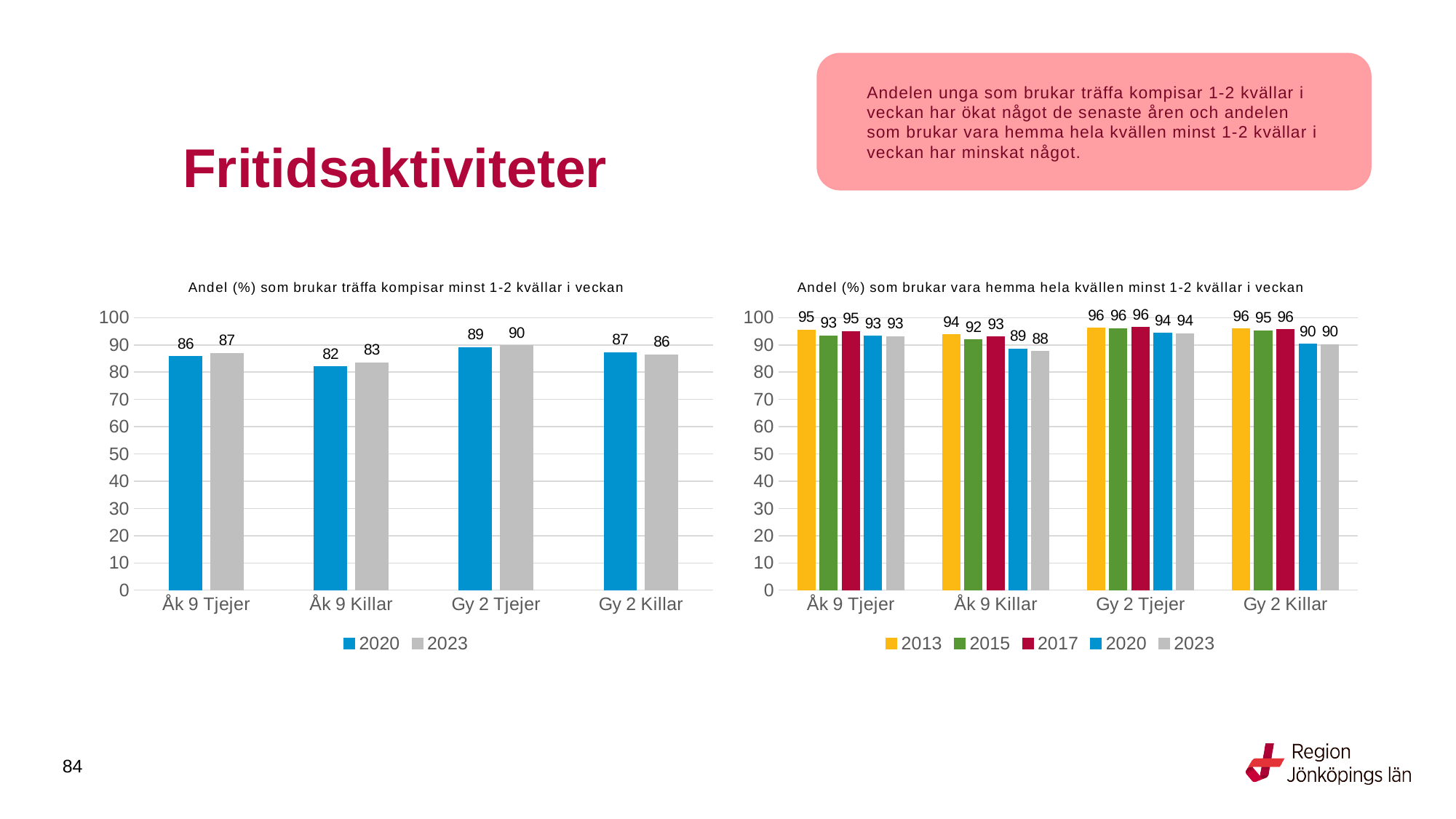
In the left chart (Andel (%) som brukar träffa kompisar minst 1-2 kvällar i veckan), what is the value for Åk 9 Killar in 2020? 82 In the right chart (Andel (%) som brukar vara hemma hela kvällen minst 1-2 kvällar i veckan), which is larger for Åk 9 Killar: the 2013 value or the 2023 value? 2013 In the right chart (Andel (%) som brukar vara hemma hela kvällen minst 1-2 kvällar i veckan), what is the value for Gy 2 Killar in 2023? 90 In the right chart (Andel (%) som brukar vara hemma hela kvällen minst 1-2 kvällar i veckan), which category has the lowest value in 2023? Åk 9 Killar In the left chart (Andel (%) som brukar träffa kompisar minst 1-2 kvällar i veckan), how many series does the legend list? 2 In the right chart (Andel (%) som brukar vara hemma hela kvällen minst 1-2 kvällar i veckan), what is the difference between the 2013 and 2023 values for Gy 2 Killar? 6 What kind of chart is the left chart (Andel (%) som brukar träffa kompisar minst 1-2 kvällar i veckan)? Bar chart In the right chart (Andel (%) som brukar vara hemma hela kvällen minst 1-2 kvällar i veckan), what is the value for Åk 9 Killar in 2020? 89 In the left chart (Andel (%) som brukar träffa kompisar minst 1-2 kvällar i veckan), which category has the lowest value in 2020? Åk 9 Killar In the right chart (Andel (%) som brukar vara hemma hela kvällen minst 1-2 kvällar i veckan), how many series does the legend list? 5 In the left chart (Andel (%) som brukar träffa kompisar minst 1-2 kvällar i veckan), what is the value for Gy 2 Tjejer in 2023? 90 In the left chart (Andel (%) som brukar träffa kompisar minst 1-2 kvällar i veckan), what is the difference between the 2023 and 2020 values for Åk 9 Tjejer? 1